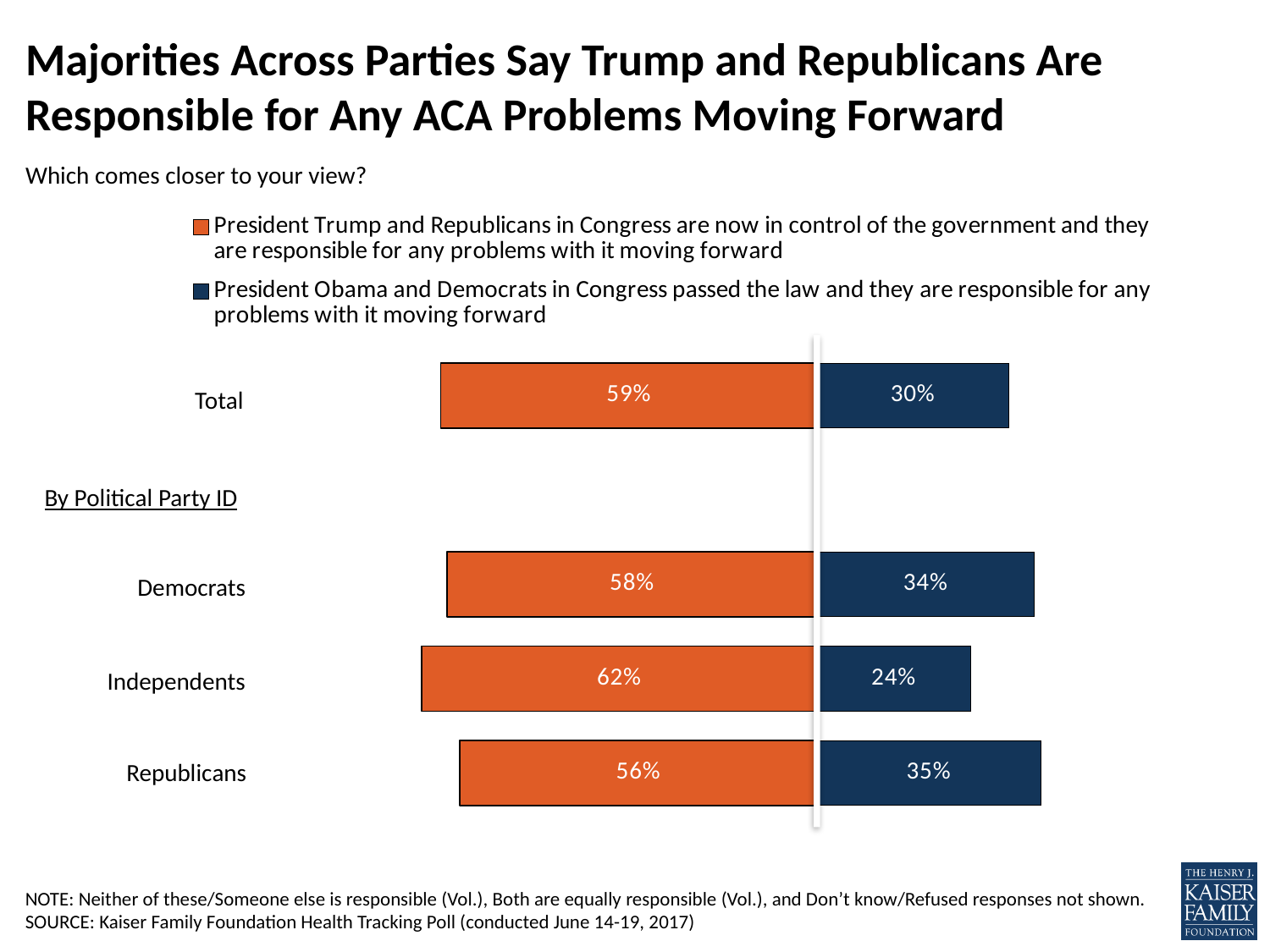
How many groups are shown in the chart? 4 Which group has the highest share saying President Trump and Republicans in Congress are responsible? Independents What percentage of the Total group say President Trump and Republicans in Congress are responsible for any ACA problems moving forward? 59% What kind of chart is shown on the slide? Bar chart How many series does the legend list? 2 What percentage of Republicans say President Trump and Republicans in Congress are responsible for any ACA problems moving forward? 56% Among Republicans, which is larger: the share saying Trump and Republicans are responsible, or the share saying Obama and Democrats are responsible? Trump and Republicans are responsible Which group has the lowest share saying President Obama and Democrats in Congress are responsible? Independents What percentage of Independents say President Obama and Democrats in Congress are responsible for any ACA problems moving forward? 24% What is the difference between the share of Democrats and the share of Republicans who say President Trump and Republicans in Congress are responsible? 2 percentage points Which colour represents the response that President Obama and Democrats in Congress are responsible? Dark blue What is the combined percentage of Democrats who chose either of the two responses shown? 92%